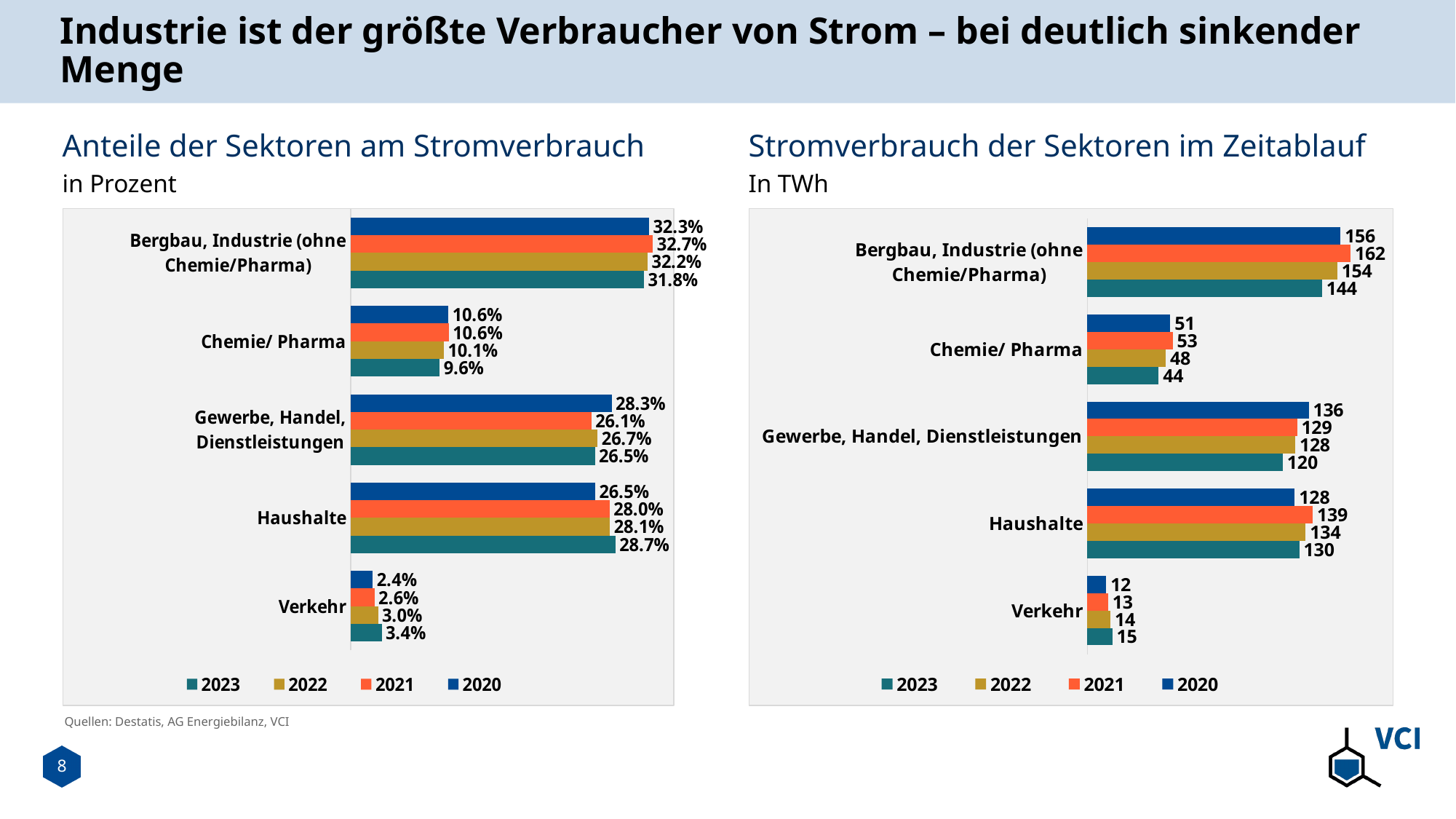
How many series does the legend of the chart 'Stromverbrauch der Sektoren im Zeitablauf' list? 4 What kind of chart is 'Stromverbrauch der Sektoren im Zeitablauf'? Bar chart In the chart 'Anteile der Sektoren am Stromverbrauch', what is the difference between the 2023 and 2020 shares for Verkehr? 1.0% In the chart 'Anteile der Sektoren am Stromverbrauch', which sector has the lowest share in 2023? Verkehr In the chart 'Stromverbrauch der Sektoren im Zeitablauf', do the values for Verkehr rise or fall from 2020 to 2023? Rise In the chart 'Stromverbrauch der Sektoren im Zeitablauf', what is the value for Chemie/ Pharma in 2023? 44 In the chart 'Anteile der Sektoren am Stromverbrauch', what is the share for Haushalte in 2021? 28.0% In the chart 'Stromverbrauch der Sektoren im Zeitablauf', what is the value for Gewerbe, Handel, Dienstleistungen in 2020? 136 How many sectors are shown in the chart 'Anteile der Sektoren am Stromverbrauch'? 5 In the chart 'Stromverbrauch der Sektoren im Zeitablauf', what is the difference between the 2021 and 2023 values for Bergbau, Industrie (ohne Chemie/Pharma)? 18 In the chart 'Stromverbrauch der Sektoren im Zeitablauf', which is larger for Haushalte: the 2020 value or the 2023 value? 2023 In the chart 'Stromverbrauch der Sektoren im Zeitablauf', which sector has the highest value in 2021? Bergbau, Industrie (ohne Chemie/Pharma)